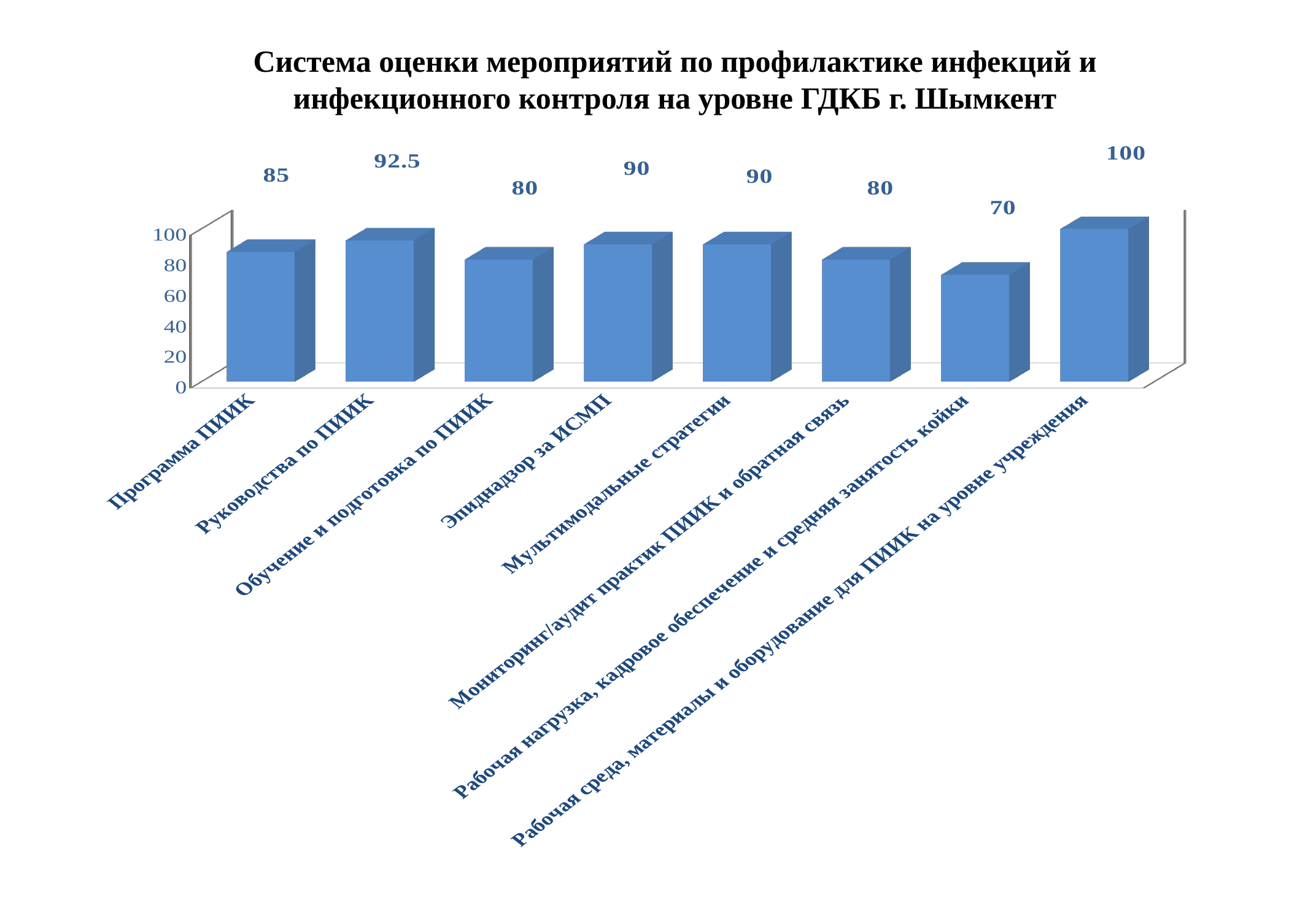
How many categories are shown in the chart? 8 Which is larger: the value for Программа ПИИК or the value for Мультимодальные стратегии? Мультимодальные стратегии What is the difference between the highest and lowest values in the chart? 30 Which category has the lowest value? Рабочая нагрузка, кадровое обеспечение и средняя занятость койки What is the value for Эпиднадзор за ИСМП? 90 What is the value for Программа ПИИК? 85 What is the title of the chart? Система оценки мероприятий по профилактике инфекций и инфекционного контроля на уровне ГДКБ г. Шымкент Which category has the highest value? Рабочая среда, материалы и оборудование для ПИИК на уровне учреждения What is the value for Рабочая нагрузка, кадровое обеспечение и средняя занятость койки? 70 What is the difference between the values for Руководства по ПИИК and Обучение и подготовка по ПИИК? 12.5 What is the value for Руководства по ПИИК? 92.5 What kind of chart is this? Bar chart